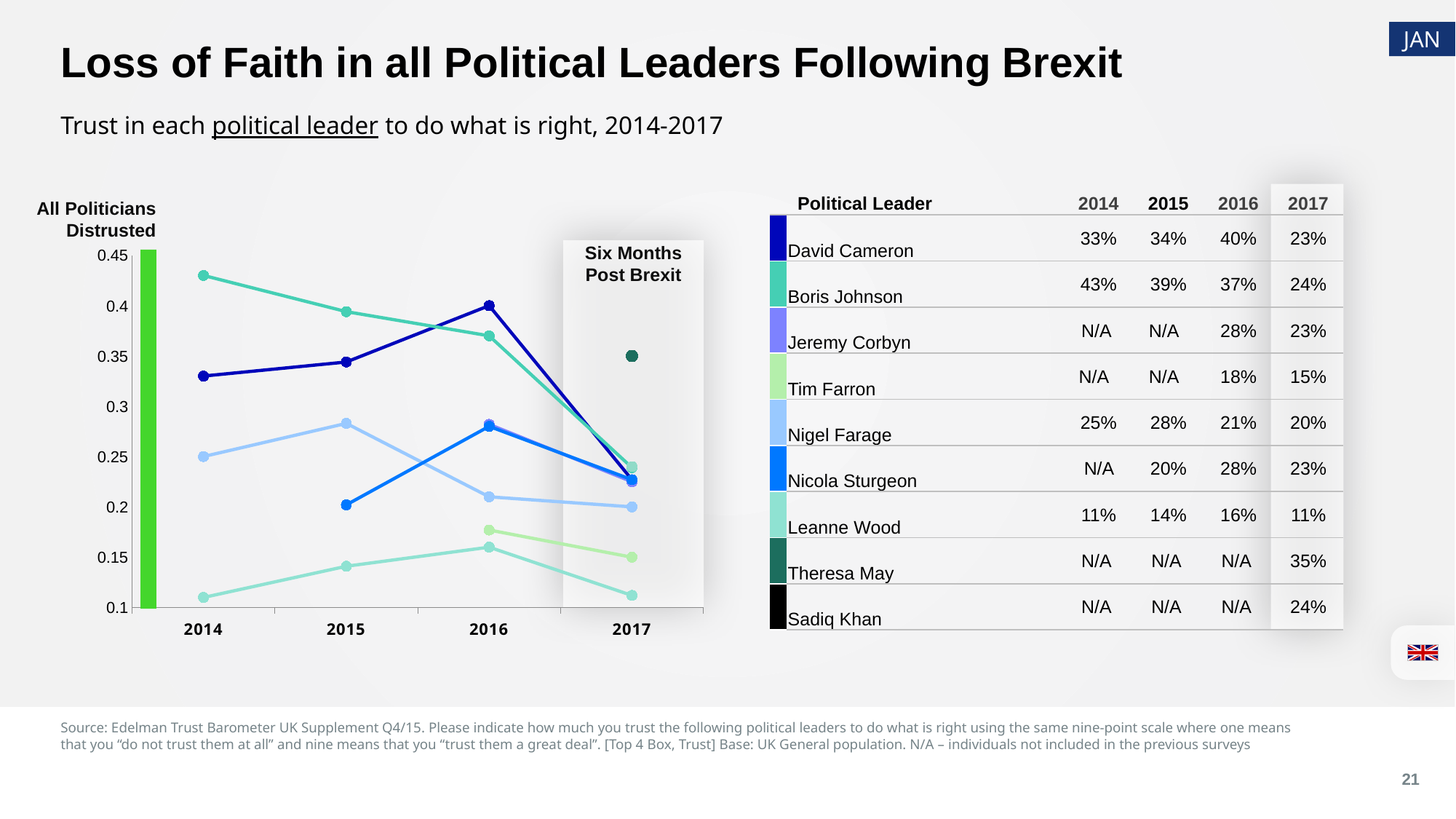
Which political leader had the highest trust value in 2017? Theresa May What kind of chart is shown on the slide? Line chart What was the trust value for Theresa May in 2017? 35% Which political leader had the lowest trust value in 2017? Leanne Wood Which political leader had the highest trust value in 2014? Boris Johnson What was the trust value for David Cameron in 2016? 40% How many political leaders are listed in the table beside the chart? 9 In 2015, who had the higher trust value, Nigel Farage or Nicola Sturgeon? Nigel Farage What was the trust value for Jeremy Corbyn in 2016? 28% How many years are shown on the x axis of the chart? 4 By how many percentage points did Boris Johnson's trust value fall from 2014 to 2017? 19 percentage points What is the label on the shaded region covering 2017 in the chart? Six Months Post Brexit